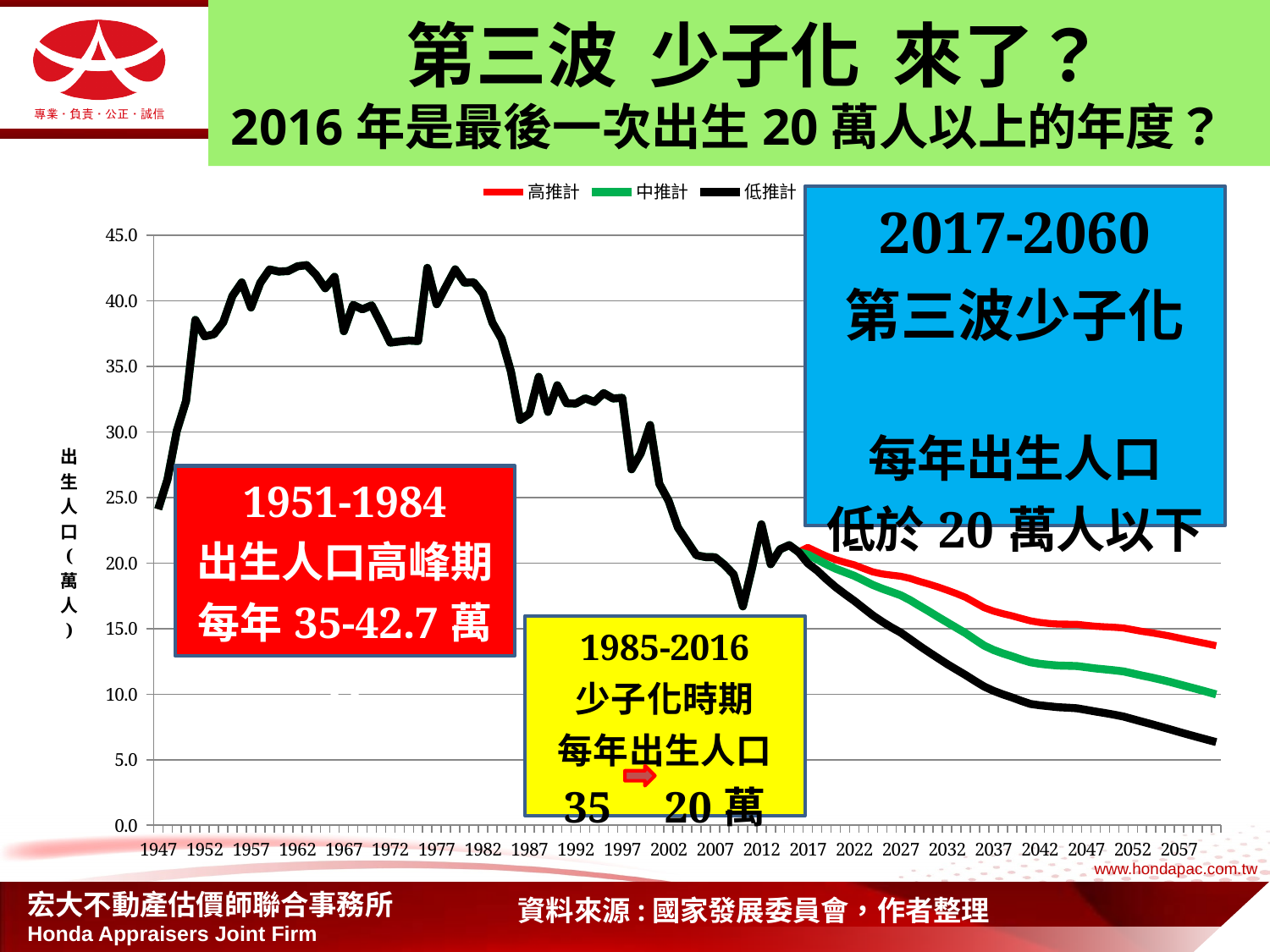
What kind of chart is shown on the slide? line chart Which series is drawn in black according to the legend? 低推計 Is the value of the 低推計 line at 2057 greater or less than 10.0? less Is the value of the black line at 1947 greater or less than 20.0? greater How many series does the legend list? 3 Does the 低推計 line rise or fall from 2017 to 2057? fall Is the value of the 高推計 line at 2057 greater or less than 15.0? less At 2057, which series has the lowest value: 高推計, 中推計 or 低推計? 低推計 Which series is drawn in red according to the legend? 高推計 At 2057, which series has the highest value: 高推計, 中推計 or 低推計? 高推計